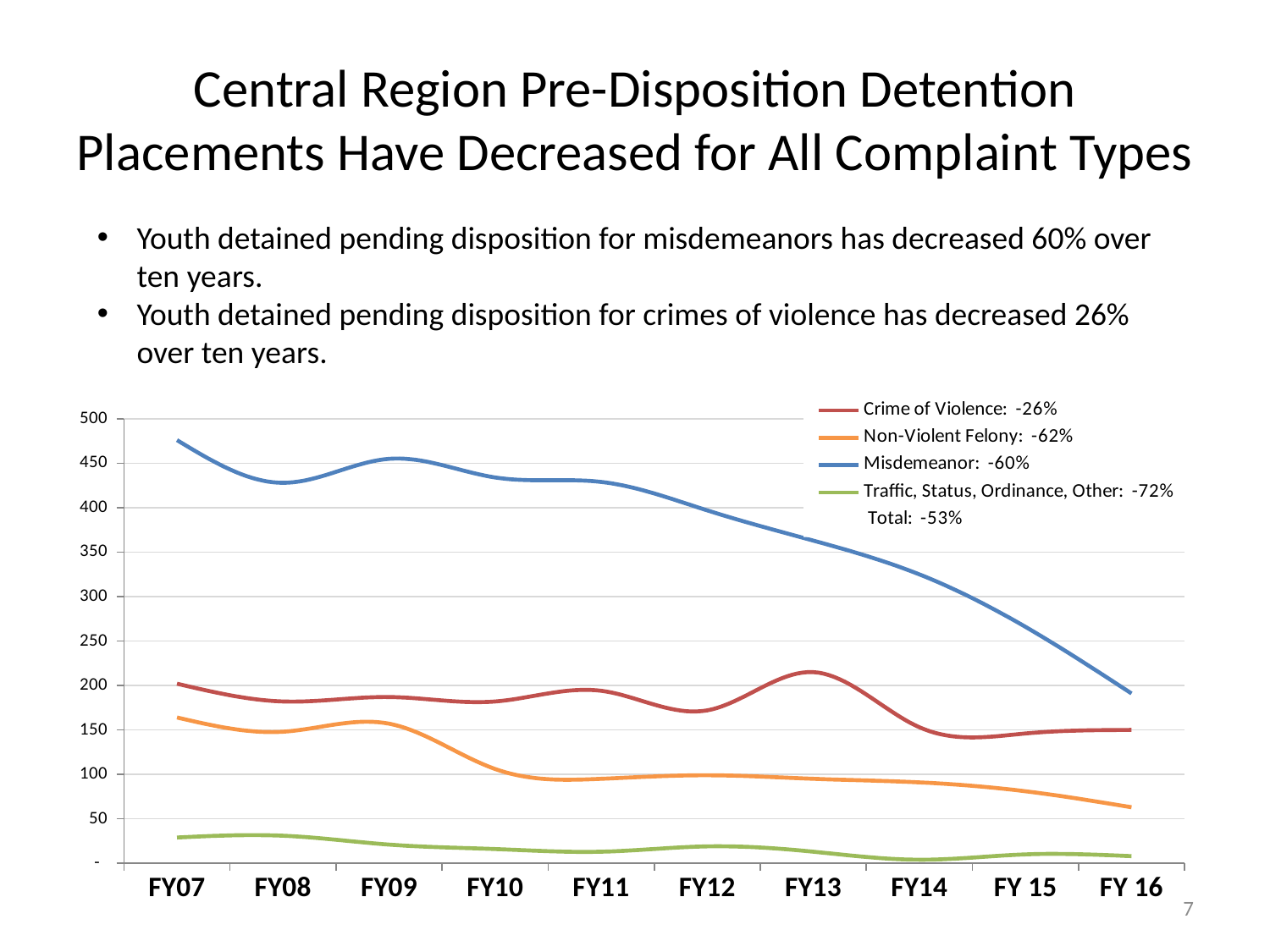
Is the Misdemeanor value for FY07 greater or less than 450? greater What kind of chart is shown on the slide? Line chart How many fiscal years are plotted along the x axis? 10 Which series has the highest value in FY07? Misdemeanor What percentage change does the legend show for Misdemeanor? -60% Is the Traffic, Status, Ordinance, Other value for FY07 greater or less than 50? less How many series are plotted as lines in the chart? 4 Does the Misdemeanor line rise or fall from FY07 to FY 16? fall Is the Misdemeanor value for FY 16 greater or less than 250? less Which series has the lowest value across all years? Traffic, Status, Ordinance, Other In FY07, which is larger: the Misdemeanor value or the Crime of Violence value? Misdemeanor